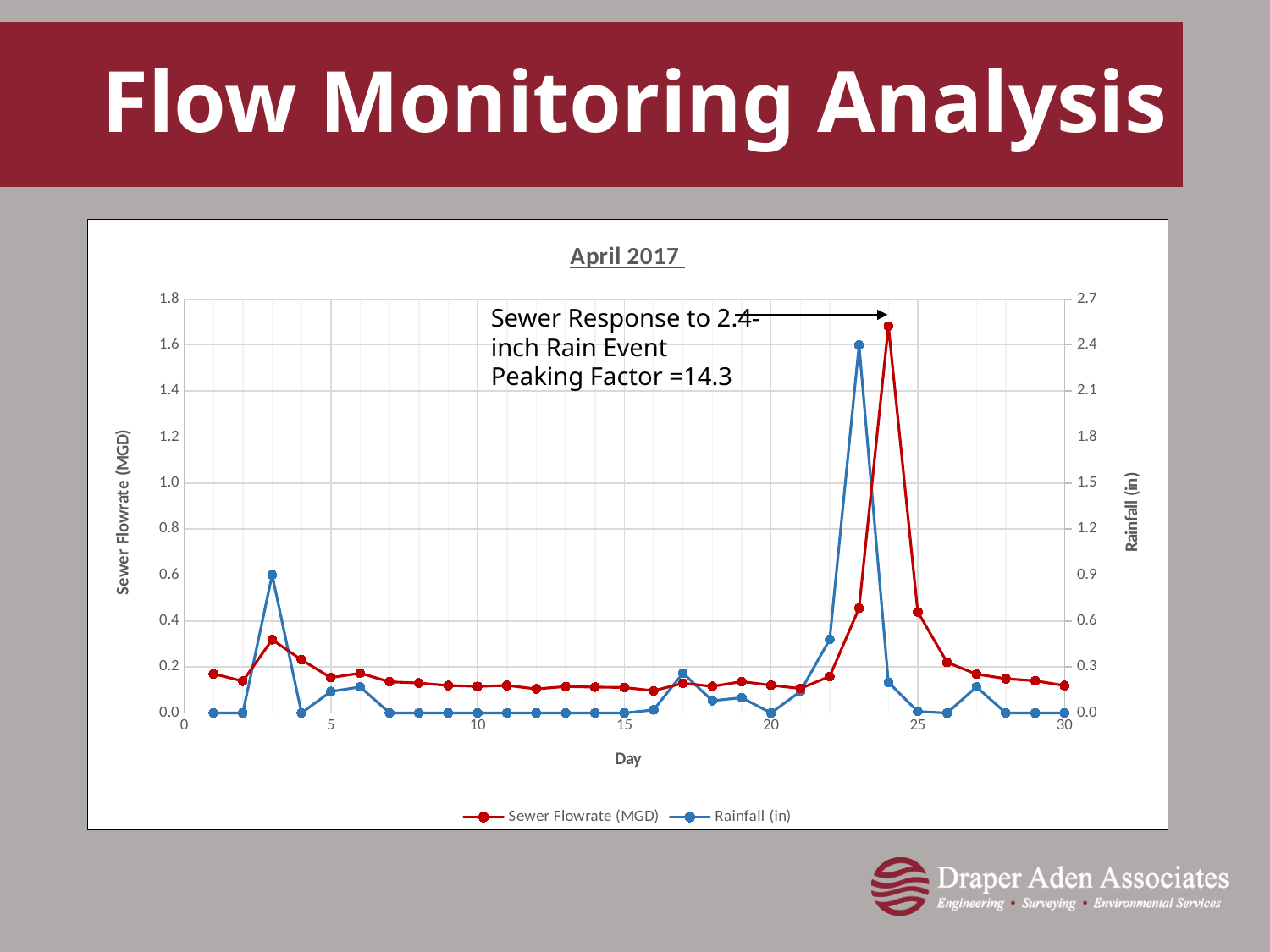
How many series does the chart legend list? 2 Is the sewer flowrate on day 3 greater or less than 0.4? less On which day does the rainfall reach its highest value? Day 23 What is the rainfall value on day 23? 2.4 What are the two series named in the chart legend? Sewer Flowrate (MGD) and Rainfall (in) Which is larger, the sewer flowrate on day 24 or the sewer flowrate on day 3? Day 24 What is the title of the chart? April 2017 On which day does the sewer flowrate reach its highest value? Day 24 Is the sewer flowrate on day 24 greater or less than 1.6? greater What is the rainfall value on day 30? 0.0 What kind of chart is shown on the slide? Line chart What is the rainfall value on day 3? 0.9